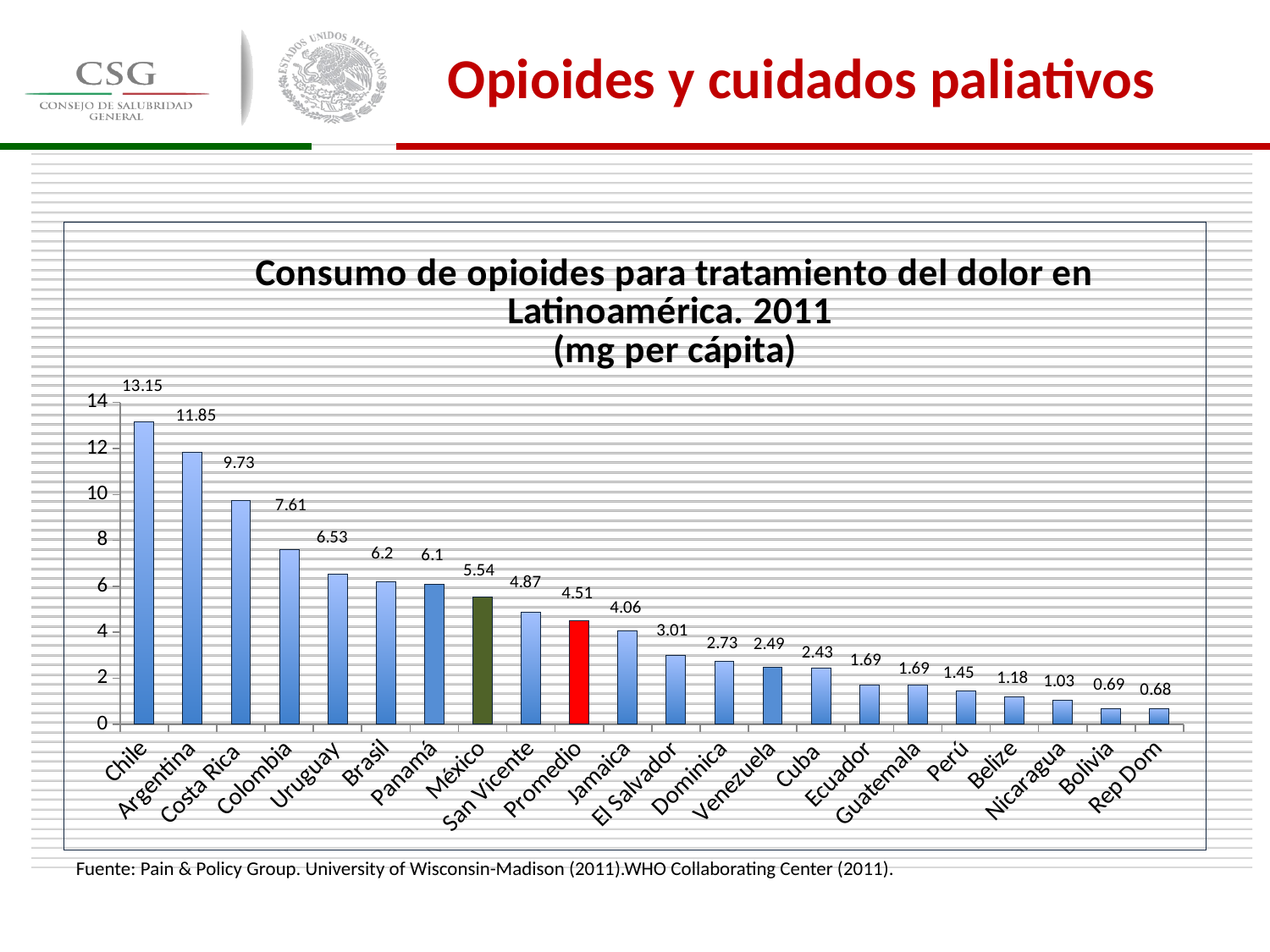
What kind of chart is this? bar chart Which is larger, the value for Brasil or the value for Panamá? Brasil How many categories are shown on the x axis? 22 Which category has the lowest value? Rep Dom What is the difference between the values for México and Promedio? 1.03 What is the difference between the values for Chile and Argentina? 1.3 What is the value for México? 5.54 Do the values rise or fall from left to right along the x axis? fall What is the value for Costa Rica? 9.73 Is the value for Colombia greater or less than 8? less Which country has the highest opioid consumption? Chile What is the value for Promedio? 4.51